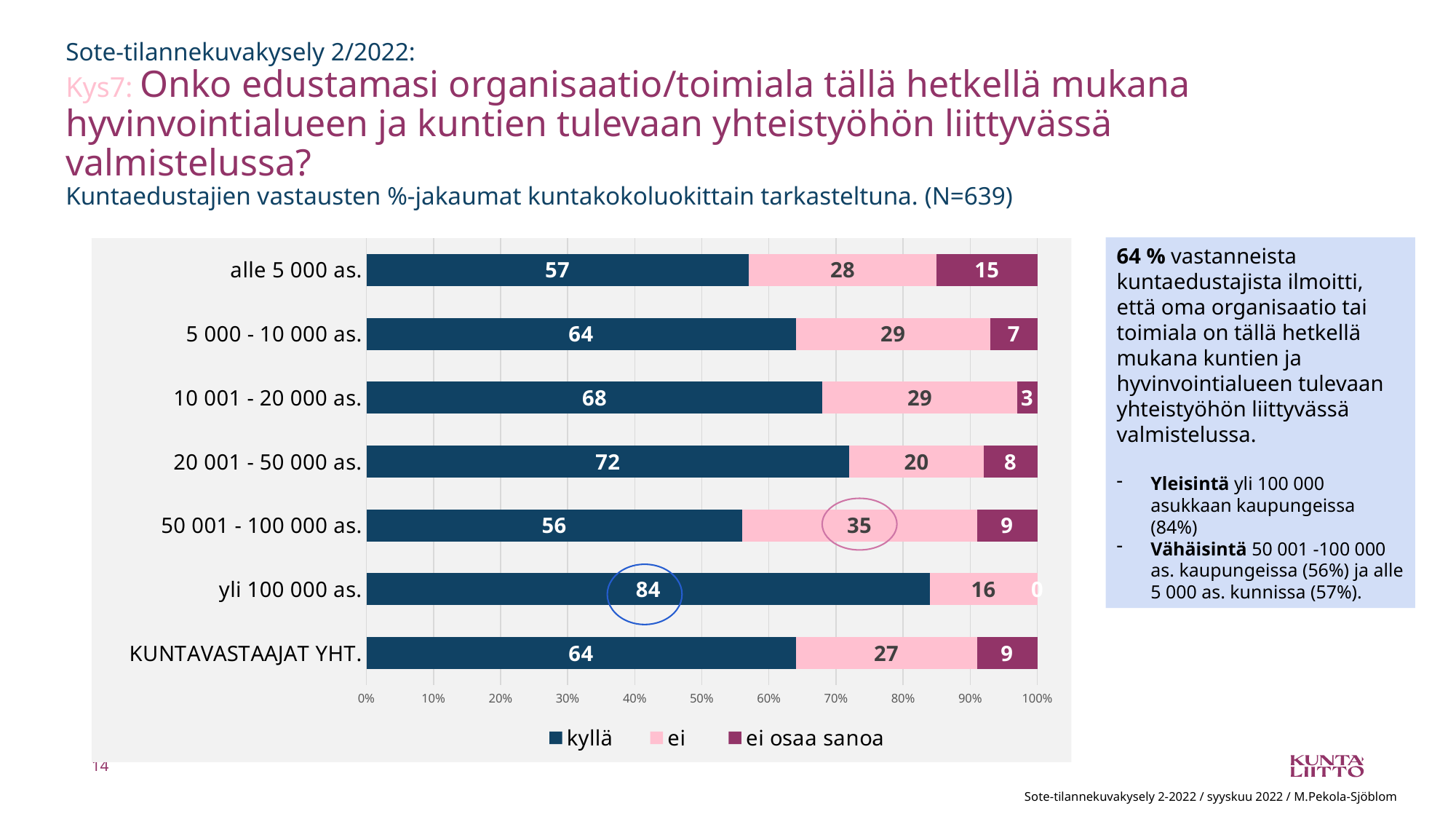
How many series does the legend list? 3 Which category has the lowest "kyllä" value? 50 001 - 100 000 as. What is the "kyllä" value for "yli 100 000 as."? 84 Which is larger: the "ei" value for "alle 5 000 as." or the "ei" value for "20 001 - 50 000 as."? alle 5 000 as. What kind of chart is shown on the slide? Stacked bar chart What is the "ei osaa sanoa" value for "alle 5 000 as."? 15 Which series is shown in light pink in the legend? ei Which category has the highest "kyllä" value? yli 100 000 as. What is the "ei" value for "50 001 - 100 000 as."? 35 What is the "kyllä" value for "KUNTAVASTAAJAT YHT."? 64 How many categories are shown on the y axis of the chart? 7 What is the difference between the "kyllä" values for "yli 100 000 as." and "50 001 - 100 000 as."? 28